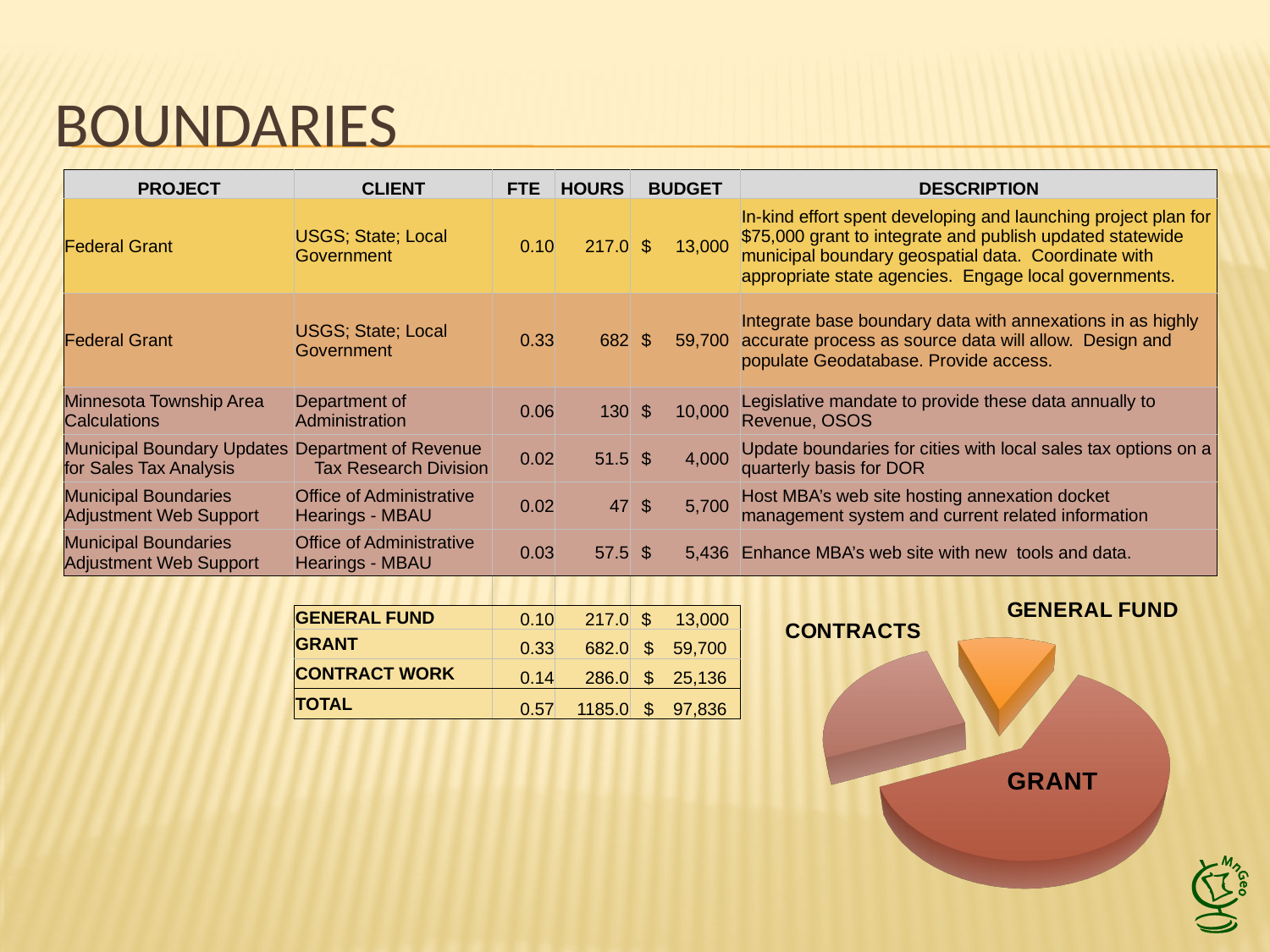
In the pie chart, which slice is larger, CONTRACTS or GENERAL FUND? CONTRACTS In the pie chart, which slice is larger, GRANT or CONTRACTS? GRANT What colour is the GENERAL FUND slice in the pie chart? orange What kind of chart is shown on the slide? pie chart Which slice of the pie chart is the smallest? GENERAL FUND What are the three slice labels shown on the pie chart? GENERAL FUND, CONTRACTS, GRANT How many slices does the pie chart have? 3 Which slice of the pie chart is the largest? GRANT